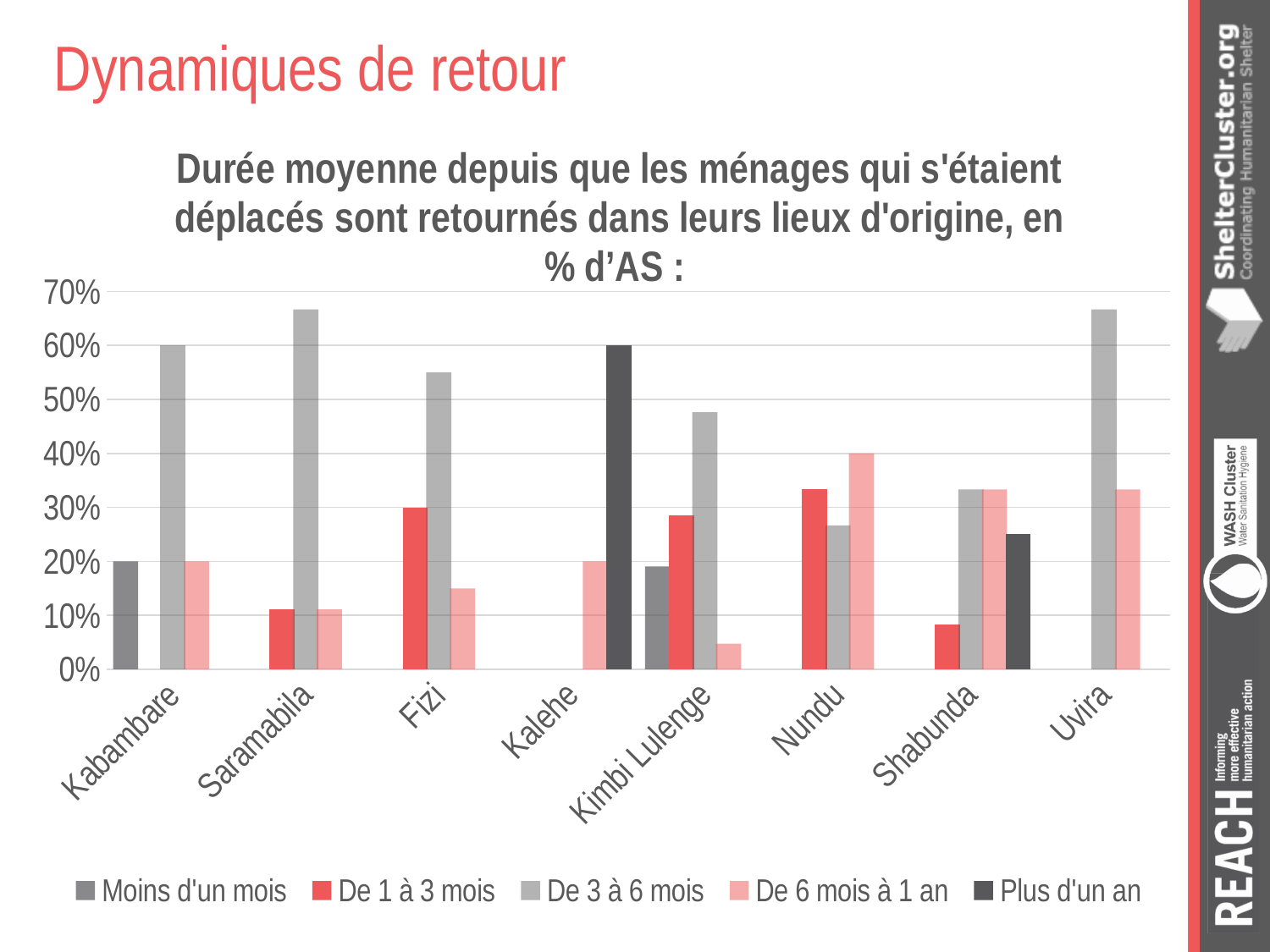
Which series has the highest value in Nundu? De 6 mois à 1 an What is the value for 'Plus d'un an' in Kalehe? 60% What is the difference between 'De 3 à 6 mois' and 'Moins d'un mois' in Kabambare? 40% What is the value for 'De 1 à 3 mois' in Fizi? 30% In Fizi, which is larger: 'De 1 à 3 mois' or 'De 6 mois à 1 an'? De 1 à 3 mois Is the value for 'Plus d'un an' in Shabunda greater or less than 30%? less What kind of chart is shown on the slide? bar chart How many series does the legend list? 5 How many categories (locations) are shown on the x axis? 8 What is the value for 'De 3 à 6 mois' in Kabambare? 60% Is the value for 'De 3 à 6 mois' in Saramabila greater or less than 60%? greater Which series has the highest value in Kalehe? Plus d'un an